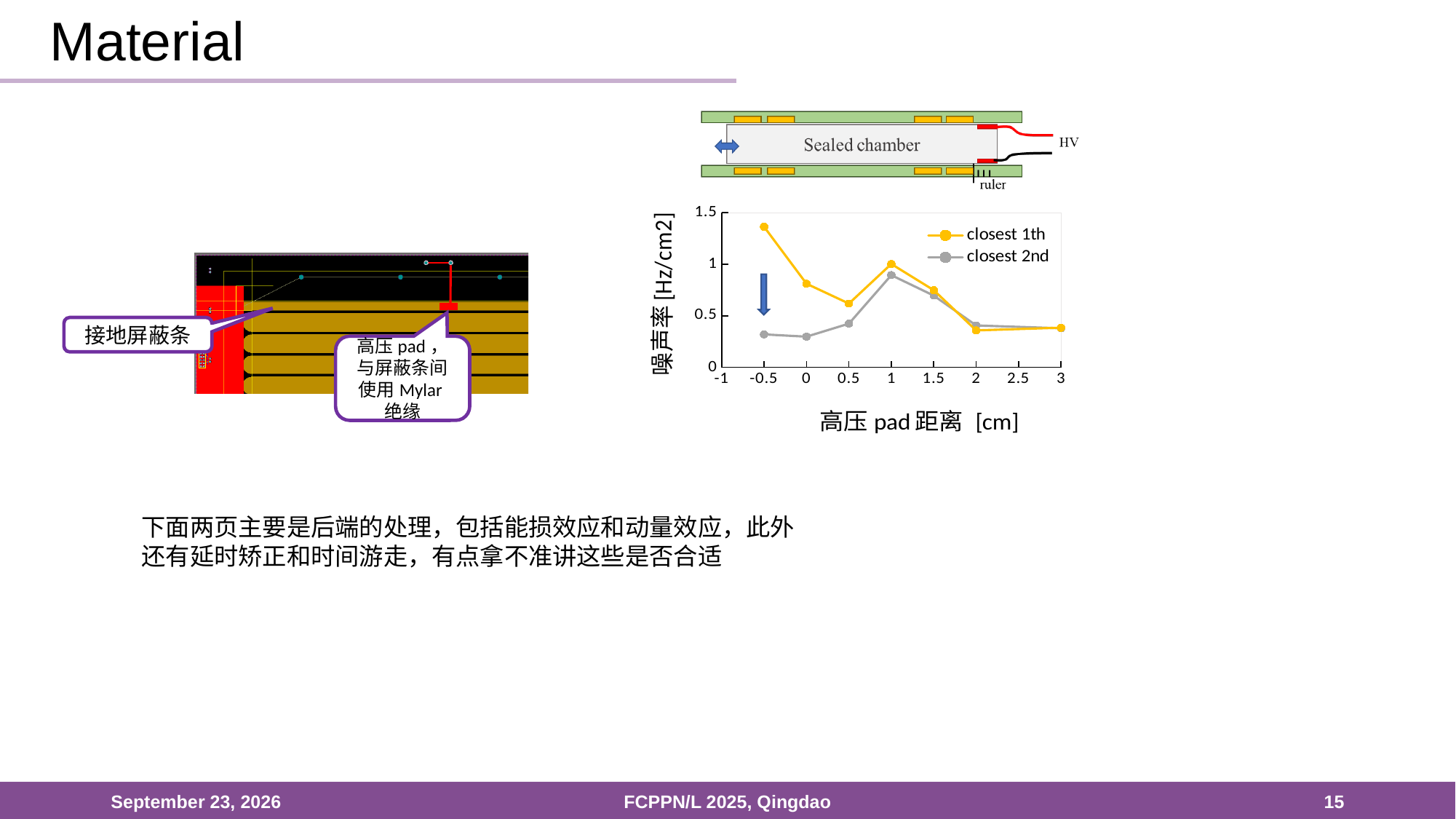
Is the closest 1th value at -0.5 cm greater or less than 1? greater Does the closest 1th series rise or fall from -0.5 cm to 0.5 cm? fall At -0.5 cm, which series has the larger value, closest 1th or closest 2nd? closest 1th At which x-axis value does the closest 1th series reach its highest point? -0.5 Is the closest 1th value at 2 cm greater or less than 0.5? less What is the y-axis label of the chart? 噪声率 [Hz/cm2] Is the closest 2nd value at 1 cm greater or less than 0.5? greater What are the two series named in the chart legend? closest 1th and closest 2nd How many series does the legend of the chart list? 2 How many data points does the closest 1th series have? 7 What kind of chart is shown on the slide? line chart